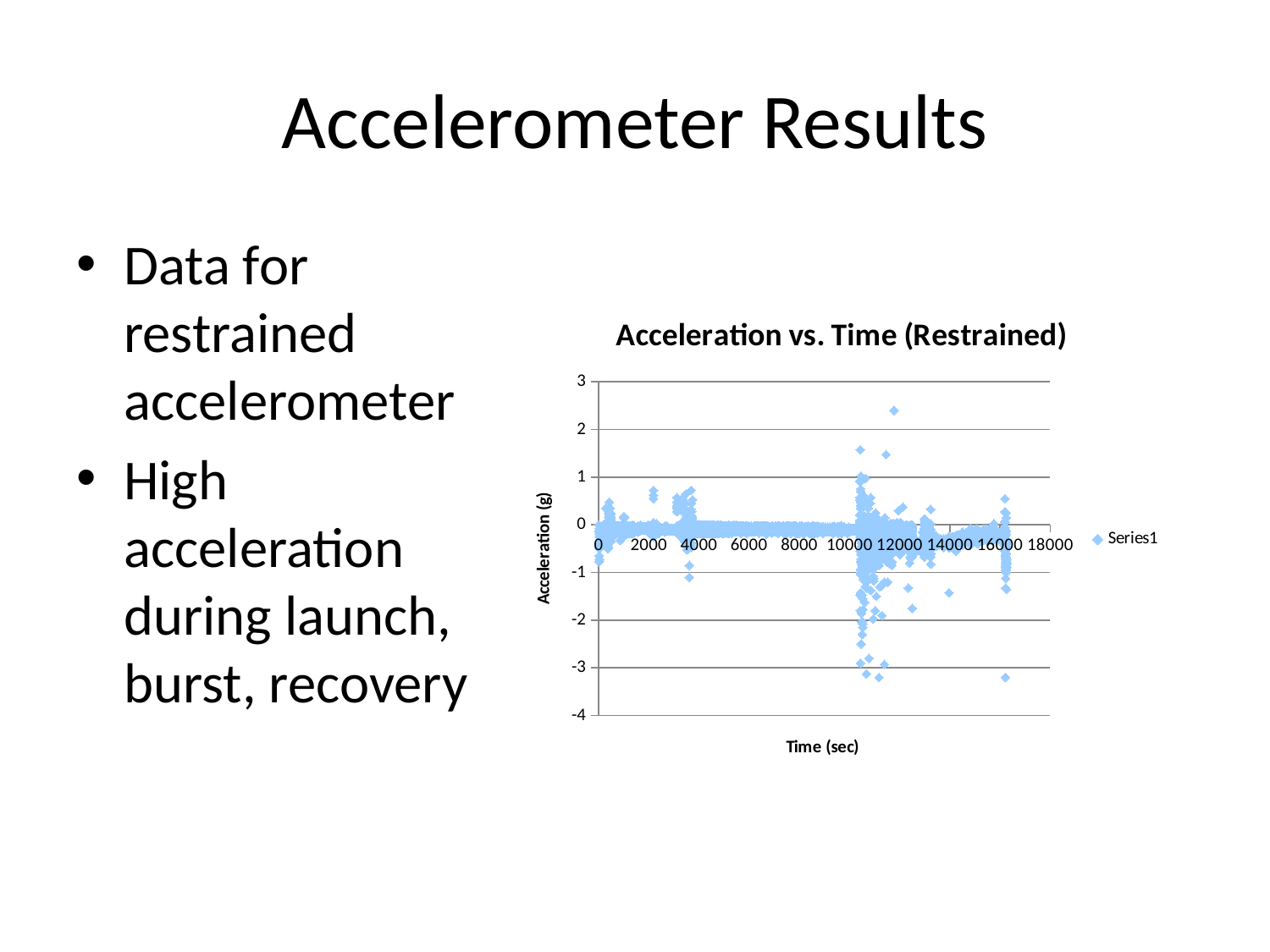
Is the lowest acceleration value plotted on the chart greater or less than -4? greater Is the acceleration value at around 8000 seconds greater or less than 1? less Is the acceleration value at around 2000 seconds greater or less than 1? less What is the title of the chart? Acceleration vs. Time (Restrained) What kind of chart is shown on the slide? scatter chart What is the label of the vertical axis of the chart? Acceleration (g) How many series does the chart legend list? 1